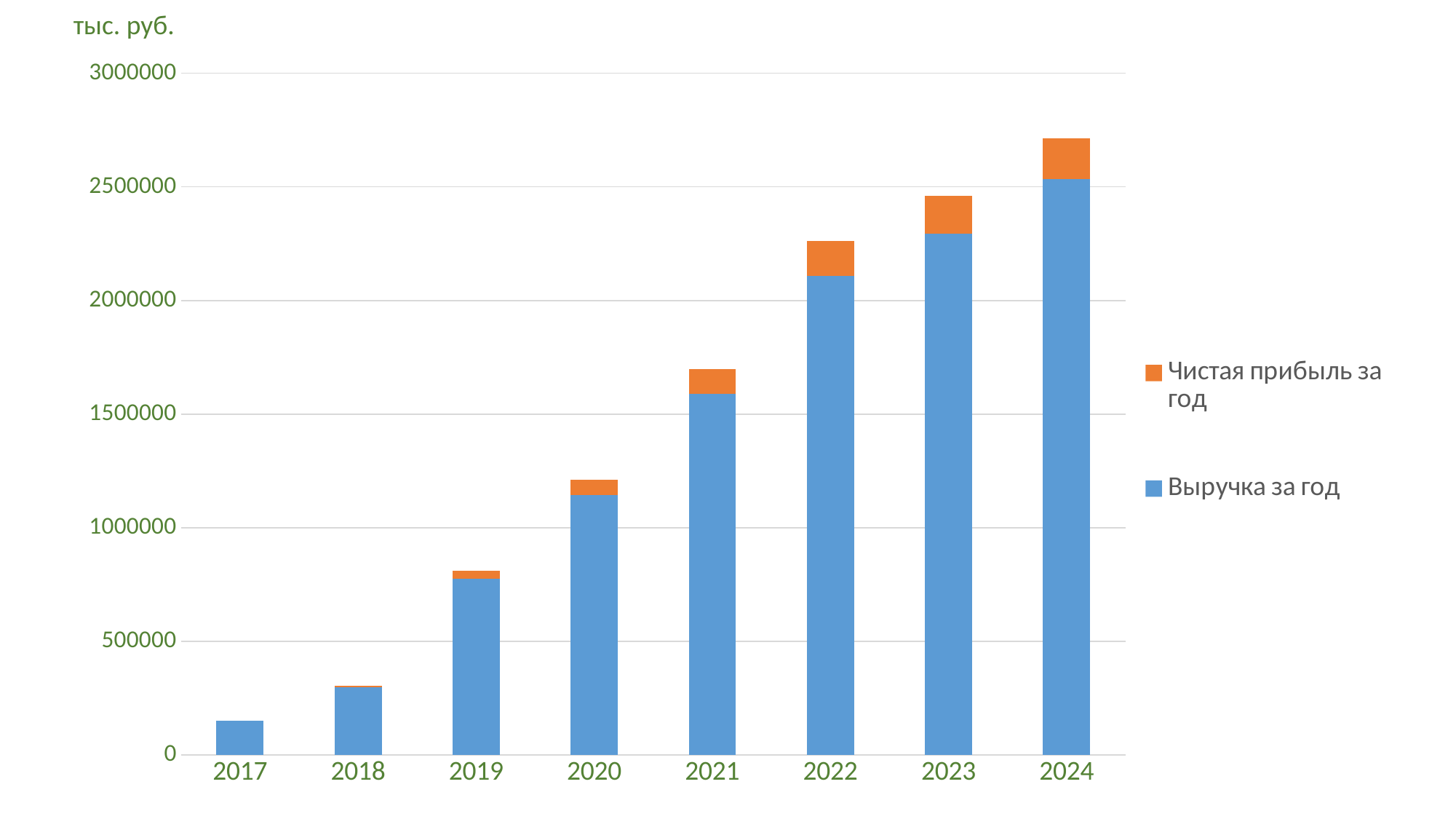
Which year has the larger Выручка за год value, 2021 or 2023? 2023 Which year has the shortest stacked bar in the chart? 2017 Which series is shown in orange in the chart? Чистая прибыль за год Is the value of Выручка за год for 2018 greater or less than 500000? less What kind of chart is shown on the slide? Stacked bar chart What unit is shown above the vertical axis of the chart? тыс. руб. Is the total stacked bar for 2024 greater or less than 2500000? greater Do the stacked bar totals rise or fall from 2017 to 2024? Rise Is the value of Выручка за год for 2019 greater or less than 1000000? less How many years are shown on the x axis of the chart? 8 How many series does the chart legend list? 2 Which year has the tallest stacked bar in the chart? 2024